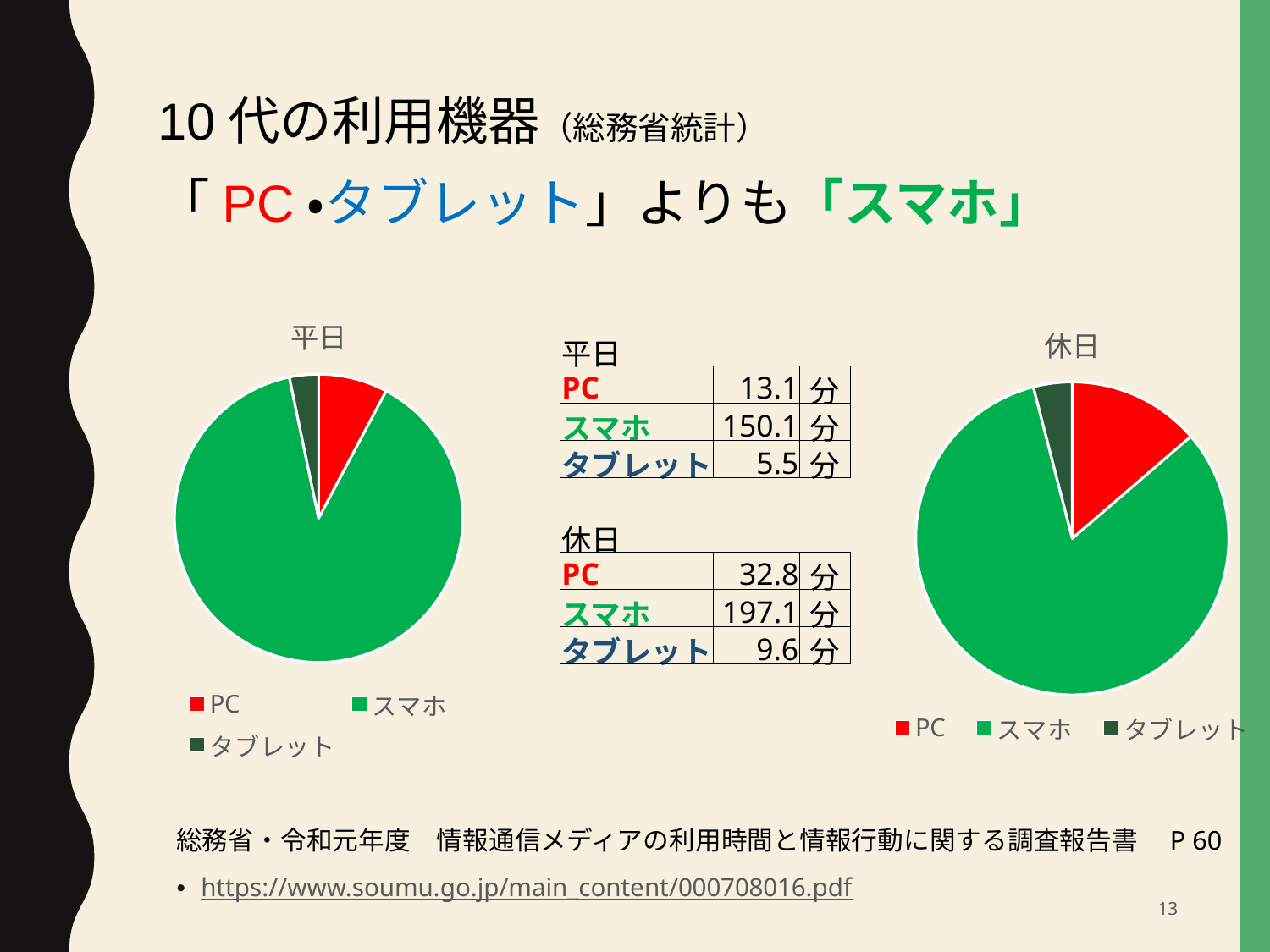
In the 平日 pie chart, which category has the largest slice? スマホ In the 休日 pie chart, what is the difference between PC and タブレット? 23.2分 What colour is the スマホ slice in the 平日 pie chart? green What kind of chart is the 休日 chart? pie chart In the 平日 pie chart, what is the value for スマホ? 150.1分 In the 休日 pie chart, what is the value for PC? 32.8分 In the 平日 pie chart, what is the difference between スマホ and PC? 137.0分 In the 休日 pie chart, which category has the smallest slice? タブレット In the 平日 pie chart, what is the value for タブレット? 5.5分 In the 休日 pie chart, which is larger, PC or タブレット? PC In the 休日 pie chart, what is the value for タブレット? 9.6分 How many categories does the 平日 pie chart show? 3